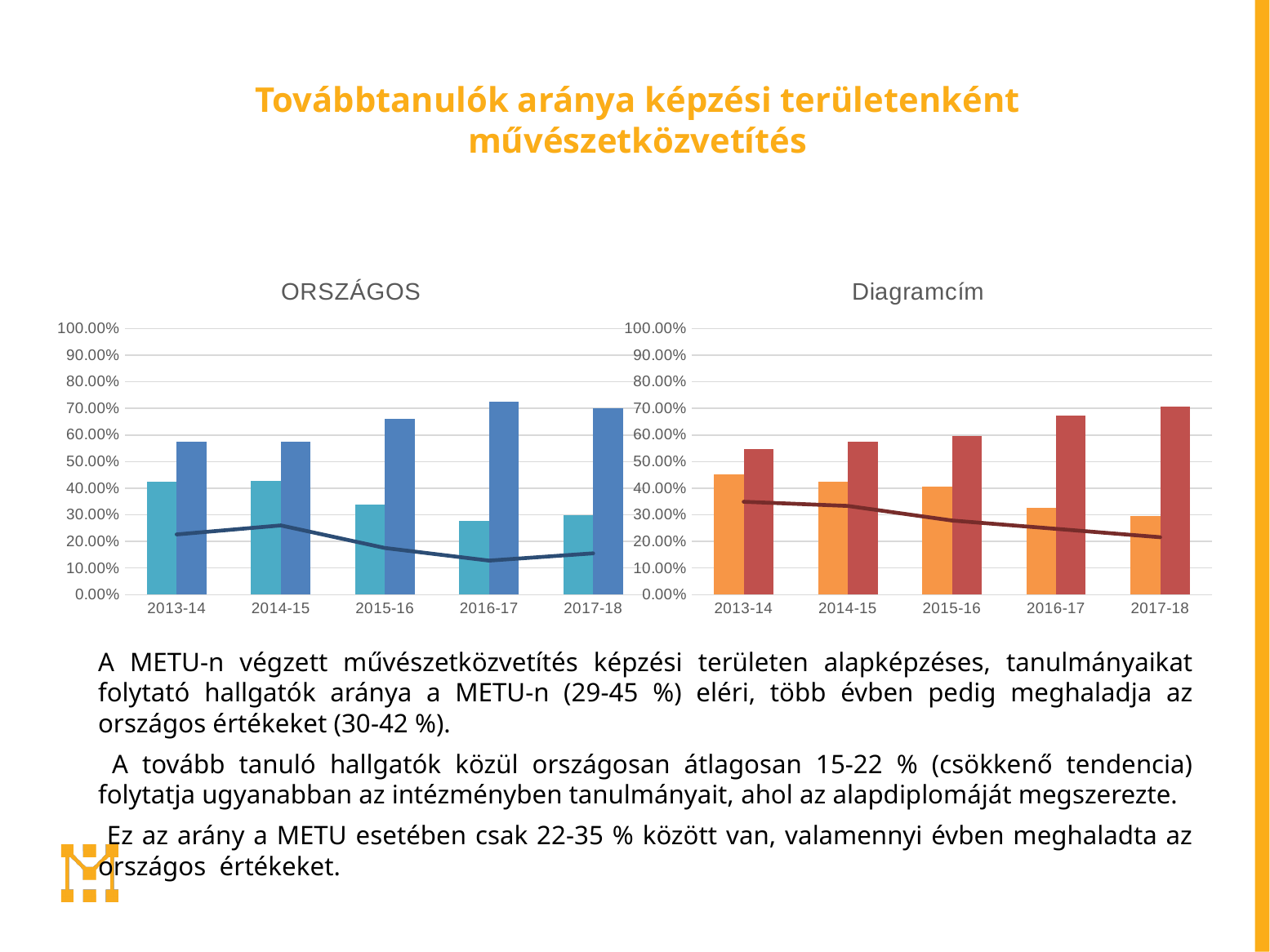
In the chart titled Diagramcím, which is larger for 2015-16: the orange bar or the red bar? the red bar In the chart titled Diagramcím, which category has the lowest orange bar? 2017-18 What is the title of the chart on the left side of the slide? ORSZÁGOS In the chart titled ORSZÁGOS, is the light blue bar for 2016-17 greater or less than 30%? less In the chart titled ORSZÁGOS, which category has the highest dark blue bar? 2016-17 In the chart titled Diagramcím, which category has the highest red bar? 2017-18 In the chart titled ORSZÁGOS, is the dark blue bar for 2016-17 greater or less than 70%? greater In the chart titled Diagramcím, is the orange bar for 2013-14 greater or less than 40%? greater In the chart titled ORSZÁGOS, which category has the lowest point on the line? 2016-17 How many categories are shown on the x axis of the chart titled Diagramcím on the right? 5 What kind of chart is the chart titled ORSZÁGOS on the left? bar chart with a line In the chart titled Diagramcím, do the values of the line rise or fall from 2013-14 to 2017-18? fall